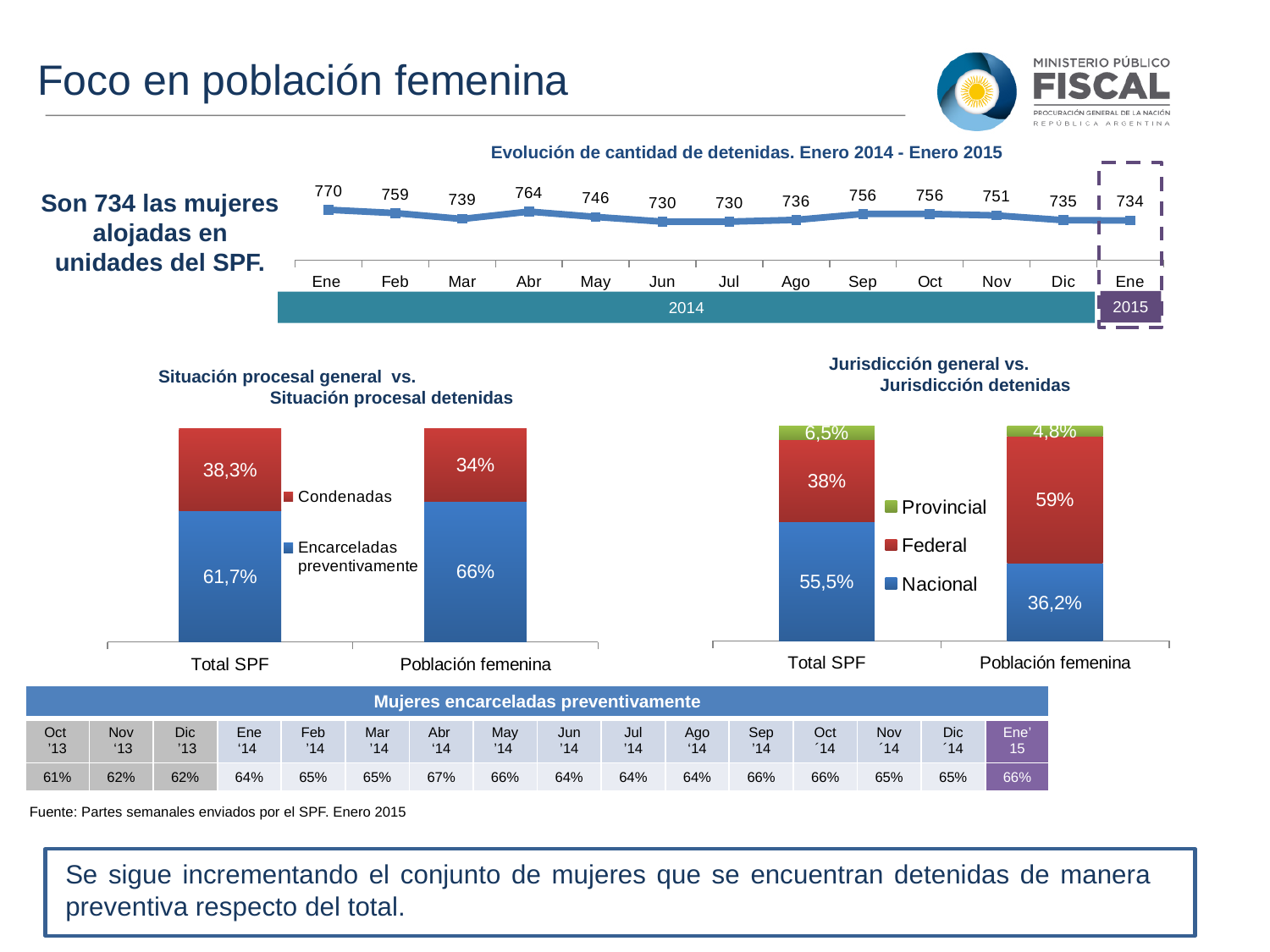
In the chart 'Evolución de cantidad de detenidas. Enero 2014 - Enero 2015', which month has the highest value? Ene 2014 In the chart 'Evolución de cantidad de detenidas. Enero 2014 - Enero 2015', which month has the lowest value? Jun and Jul 2014 (730) In the chart 'Situación procesal general vs. Situación procesal detenidas', what is the value of 'Encarceladas preventivamente' for Población femenina? 66% In the chart 'Jurisdicción general vs. Jurisdicción detenidas', which is larger: 'Federal' for Total SPF or 'Federal' for Población femenina? Federal for Población femenina In the chart 'Evolución de cantidad de detenidas. Enero 2014 - Enero 2015', what is the difference between the value for Ene 2014 and the value for Ene 2015? 36 In the chart 'Jurisdicción general vs. Jurisdicción detenidas', what is the value of 'Nacional' for Población femenina? 36,2% In the chart 'Evolución de cantidad de detenidas. Enero 2014 - Enero 2015', what is the value for Ene 2014? 770 In the chart 'Evolución de cantidad de detenidas. Enero 2014 - Enero 2015', how many data points are plotted? 13 In the chart 'Situación procesal general vs. Situación procesal detenidas', how many series does the legend list? 2 In the chart 'Situación procesal general vs. Situación procesal detenidas', what is the value of 'Condenadas' for Total SPF? 38,3% In the chart 'Jurisdicción general vs. Jurisdicción detenidas', what is the value of 'Provincial' for Total SPF? 6,5% What kind of chart is 'Evolución de cantidad de detenidas. Enero 2014 - Enero 2015'? Line chart